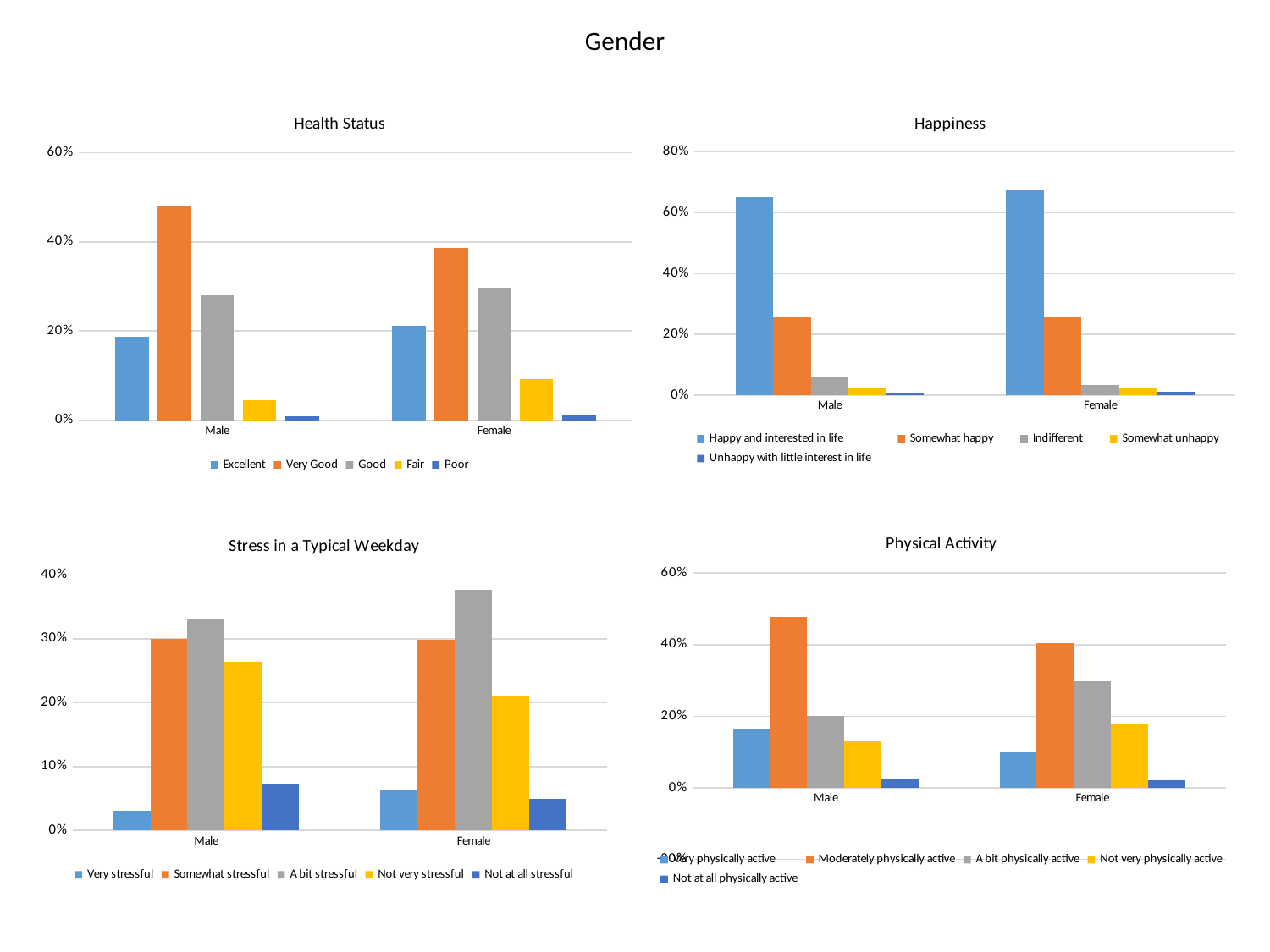
In the Stress in a Typical Weekday chart, which series has the highest value for Female? A bit stressful In the Health Status chart, how many series does the legend list? 5 In the Physical Activity chart, how many categories are shown on the x axis? 2 In the Stress in a Typical Weekday chart, is the Not very stressful value larger for Male or Female? Male In the Health Status chart, what kind of chart is shown? bar chart In the Physical Activity chart, which series has the highest value for Male? Moderately physically active In the Physical Activity chart, is the A bit physically active value larger for Male or Female? Female In the Health Status chart, is the Very Good value for Male greater or less than 40%? greater In the Happiness chart, which series has the lowest value for Female? Unhappy with little interest in life In the Stress in a Typical Weekday chart, is the Very stressful value for Male greater or less than 10%? less In the Happiness chart, is the value for Happy and interested in life for Male greater or less than 60%? greater In the Health Status chart, which series has the highest value for Male? Very Good